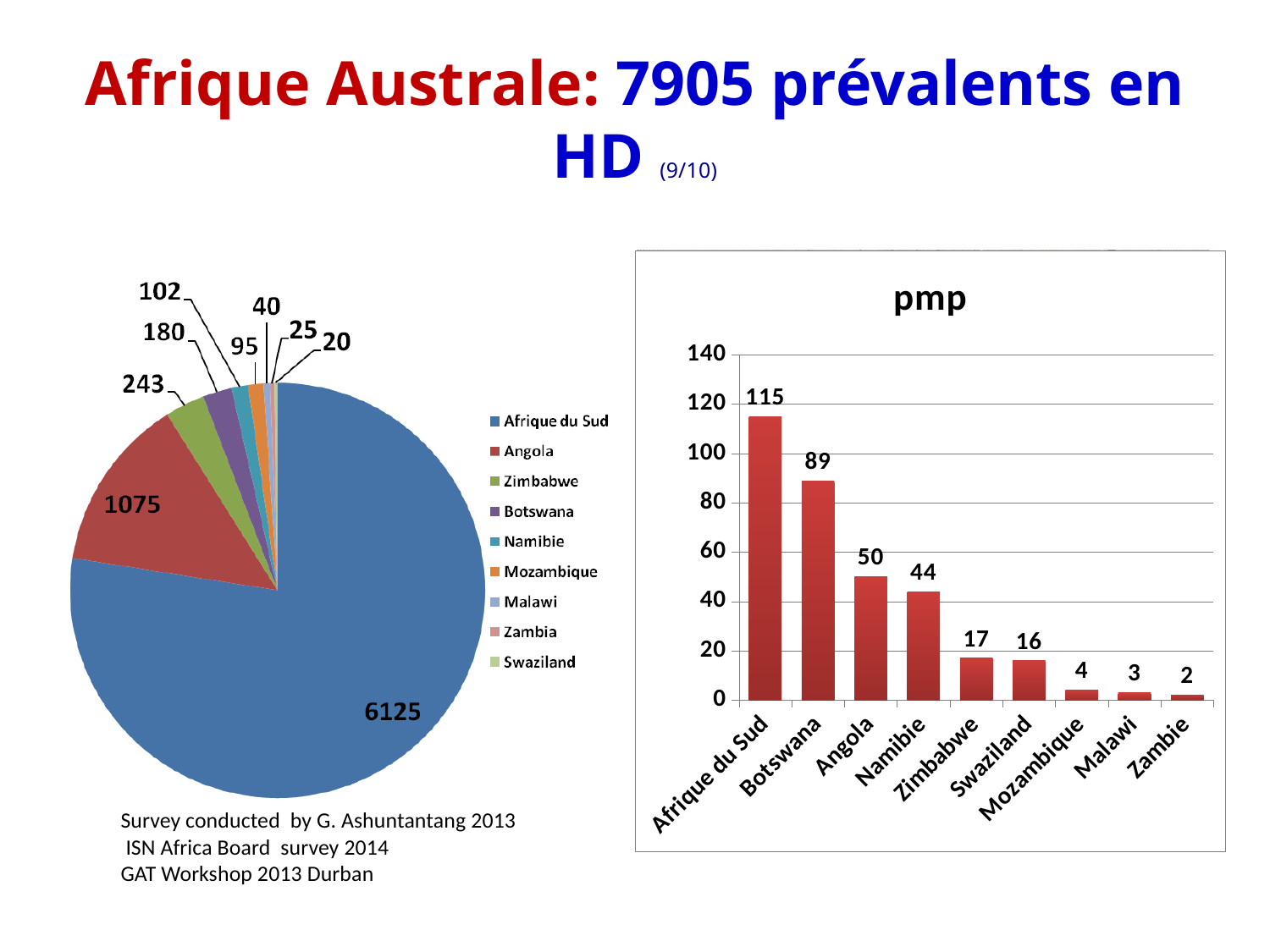
What kind of chart is the chart on the right of the slide? bar chart In the bar chart titled pmp, what is the difference between the values for Afrique du Sud and Botswana? 26 In the bar chart titled pmp, which country has the highest value? Afrique du Sud In the bar chart titled pmp, which country has the lowest value? Zambie In the pie chart on the left, how many categories does the legend list? 9 In the bar chart titled pmp, how many countries are shown on the x axis? 9 In the pie chart on the left, what is the value for Angola? 1075 In the bar chart titled pmp, do the values rise or fall from left to right along the x axis? fall In the pie chart on the left, what is the value for Afrique du Sud? 6125 In the bar chart titled pmp, which is larger, the value for Angola or the value for Zimbabwe? Angola In the bar chart titled pmp, what is the value for Botswana? 89 In the bar chart titled pmp, what is the value for Namibie? 44